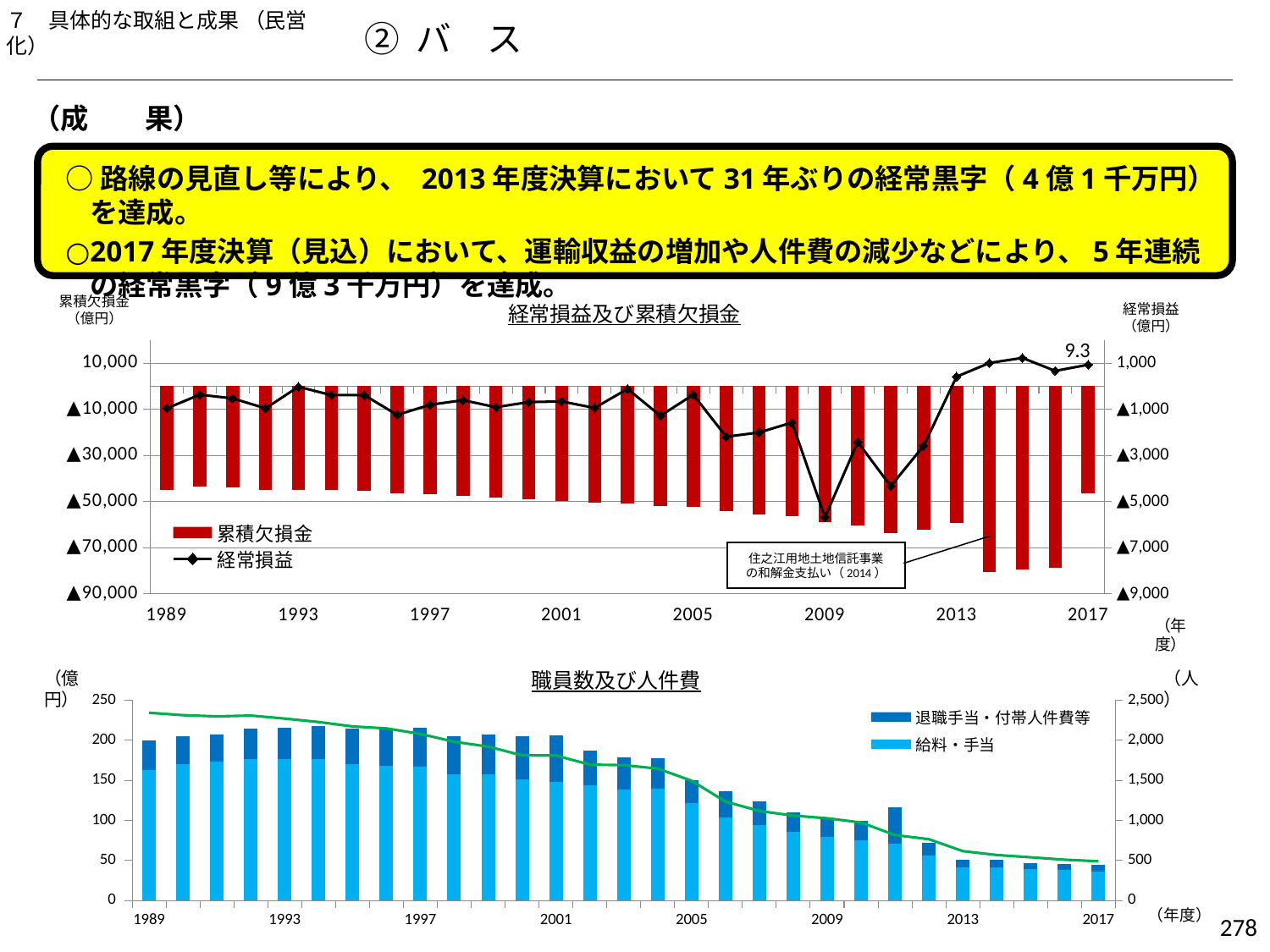
In the top chart (経常損益及び累積欠損金), what is the labelled value of 経常損益 for 2017? 9.3 In the top chart (経常損益及び累積欠損金), is the 経常損益 value for 2013 higher or lower than the value for 2009? Higher In the top chart (経常損益及び累積欠損金), does the 経常損益 line rise or fall between 2009 and 2015? Rises What is the title of the bottom chart on the slide? 職員数及び人件費 In the bottom chart (職員数及び人件費), is the total height of the stacked bar for 1989 greater or less than 150? greater How many series does the legend of the bottom chart (職員数及び人件費) list? 2 What kind of chart is the top chart titled 経常損益及び累積欠損金? A combined bar and line chart In the bottom chart (職員数及び人件費), does the green line rise or fall from 1989 to 2017? Falls How many series does the legend of the top chart (経常損益及び累積欠損金) list? 2 In the top chart (経常損益及び累積欠損金), what colour are the 累積欠損金 bars? Red In the bottom chart (職員数及び人件費), is the stacked bar for 1989 taller or shorter than the stacked bar for 2017? Taller In the top chart (経常損益及び累積欠損金), which year has the lowest 経常損益 value on the line? 2009